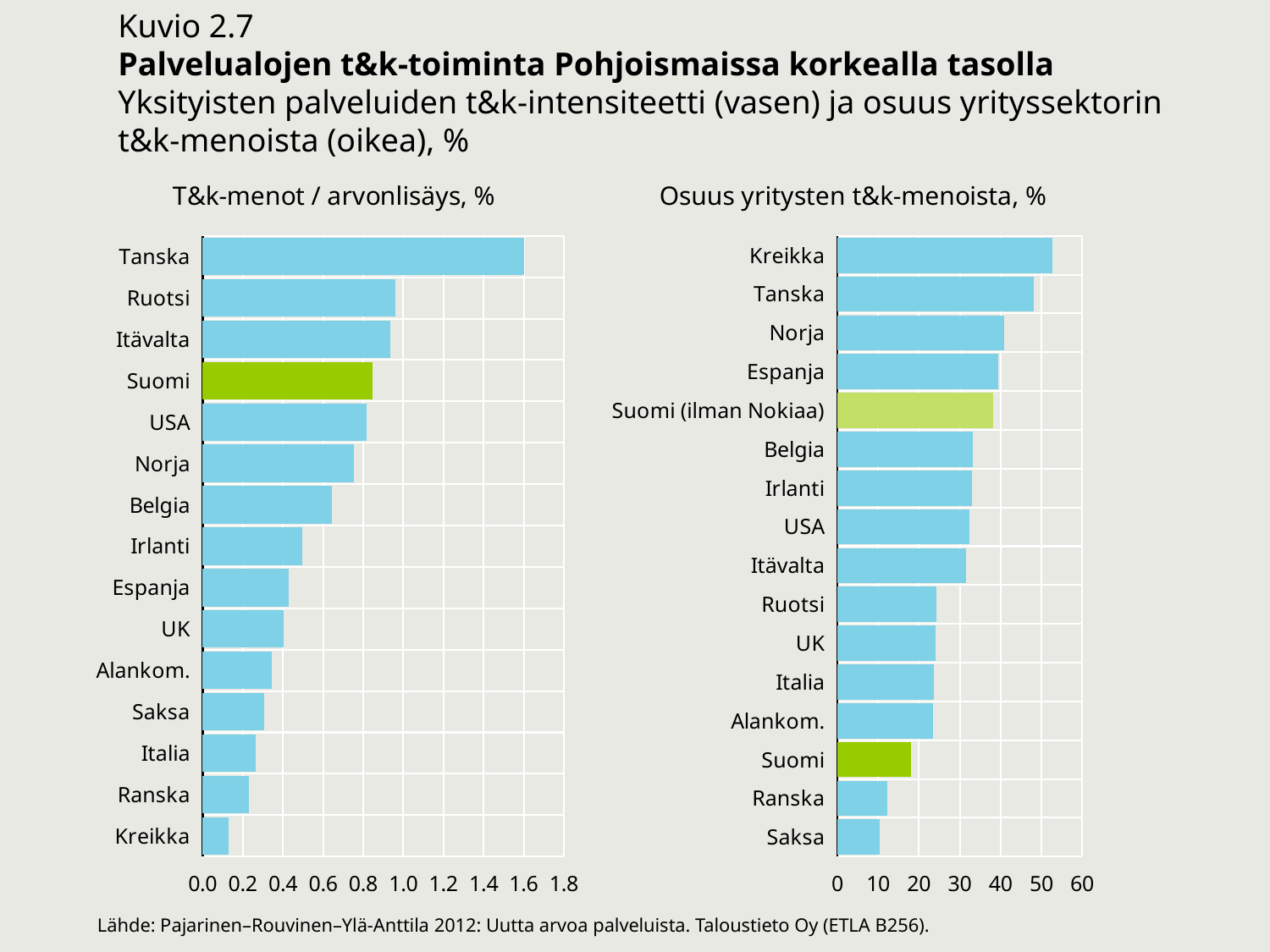
In the right chart (Osuus yritysten t&k-menoista, %), is the value for Kreikka greater or less than 50? greater How many countries are shown in the left chart (T&k-menot / arvonlisäys, %)? 15 In the left chart (T&k-menot / arvonlisäys, %), is the value for Tanska greater or less than 1.4? greater In the right chart (Osuus yritysten t&k-menoista, %), which country has the lowest value? Saksa In the right chart (Osuus yritysten t&k-menoista, %), which is larger: Suomi (ilman Nokiaa) or Suomi? Suomi (ilman Nokiaa) In the right chart (Osuus yritysten t&k-menoista, %), which country has the highest value? Kreikka What kind of chart is the left chart titled "T&k-menot / arvonlisäys, %"? bar chart In the right chart (Osuus yritysten t&k-menoista, %), is the value for Suomi greater or less than 20? less In the left chart (T&k-menot / arvonlisäys, %), which country has the highest value? Tanska How many categories are shown in the right chart (Osuus yritysten t&k-menoista, %)? 16 In the left chart (T&k-menot / arvonlisäys, %), which country's bar is highlighted in green? Suomi In the left chart (T&k-menot / arvonlisäys, %), which country has the lowest value? Kreikka